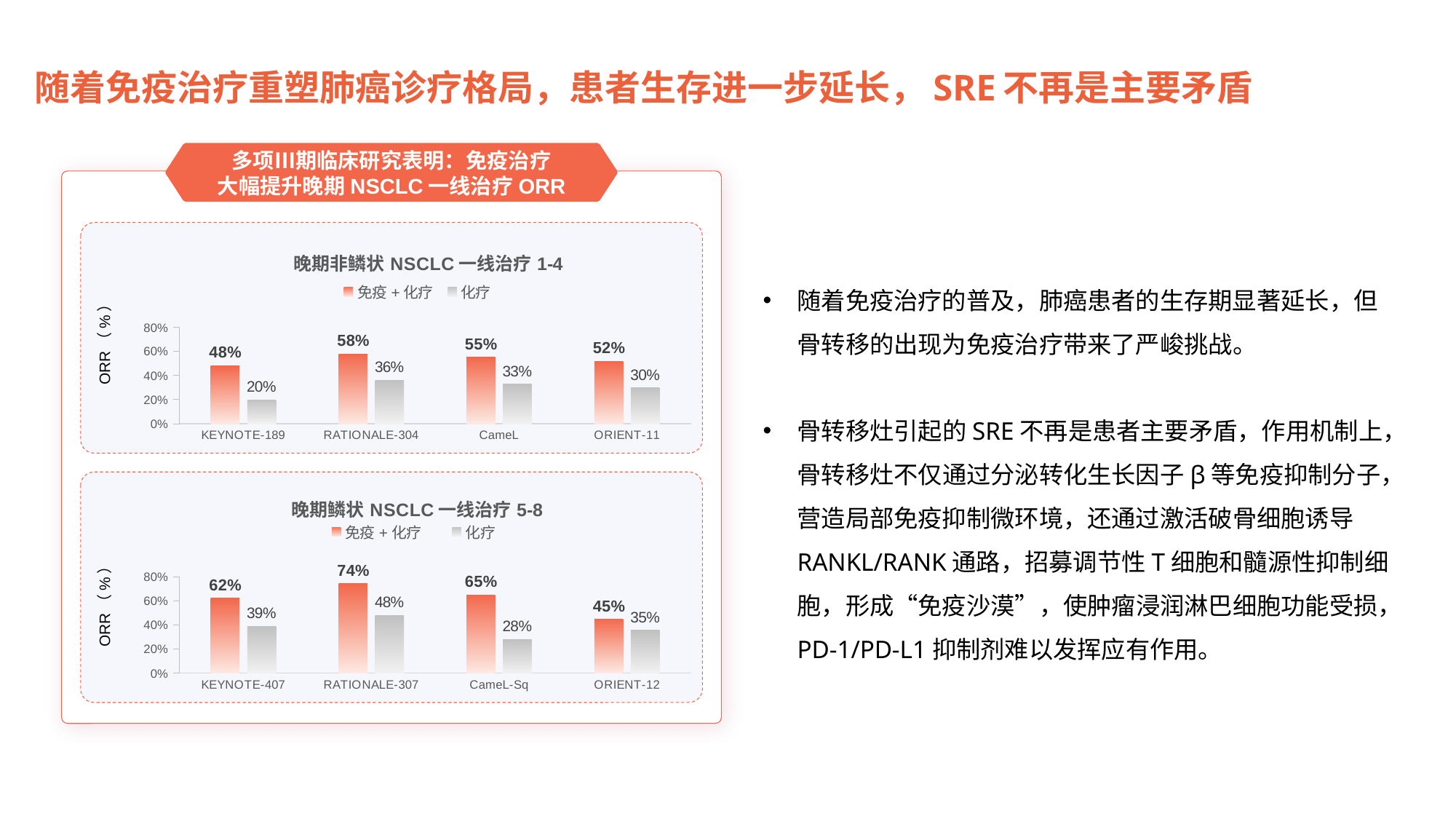
In the bottom chart (晚期鳞状 NSCLC 一线治疗 5-8), which is larger: the 化疗 ORR in KEYNOTE-407 or in ORIENT-12? KEYNOTE-407 How many series does the legend of the top chart (晚期非鳞状 NSCLC 一线治疗 1-4) list? 2 In the top chart (晚期非鳞状 NSCLC 一线治疗 1-4), what is the difference between the 免疫 + 化疗 and 化疗 ORR in CameL? 22% In the bottom chart (晚期鳞状 NSCLC 一线治疗 5-8), what is the ORR for 免疫 + 化疗 in RATIONALE-307? 74% In the bottom chart (晚期鳞状 NSCLC 一线治疗 5-8), which study has the lowest ORR for 免疫 + 化疗? ORIENT-12 In the bottom chart (晚期鳞状 NSCLC 一线治疗 5-8), what is the ORR for 化疗 in CameL-Sq? 28% In the top chart (晚期非鳞状 NSCLC 一线治疗 1-4), what is the ORR for 化疗 in RATIONALE-304? 36% What kind of chart is the bottom chart (晚期鳞状 NSCLC 一线治疗 5-8)? Bar chart In the top chart (晚期非鳞状 NSCLC 一线治疗 1-4), which study has the lowest ORR for 化疗? KEYNOTE-189 In the top chart (晚期非鳞状 NSCLC 一线治疗 1-4), what is the ORR for 免疫 + 化疗 in KEYNOTE-189? 48% In the bottom chart (晚期鳞状 NSCLC 一线治疗 5-8), what is the difference between the 免疫 + 化疗 and 化疗 ORR in KEYNOTE-407? 23% In the top chart (晚期非鳞状 NSCLC 一线治疗 1-4), which study has the highest ORR for 免疫 + 化疗? RATIONALE-304